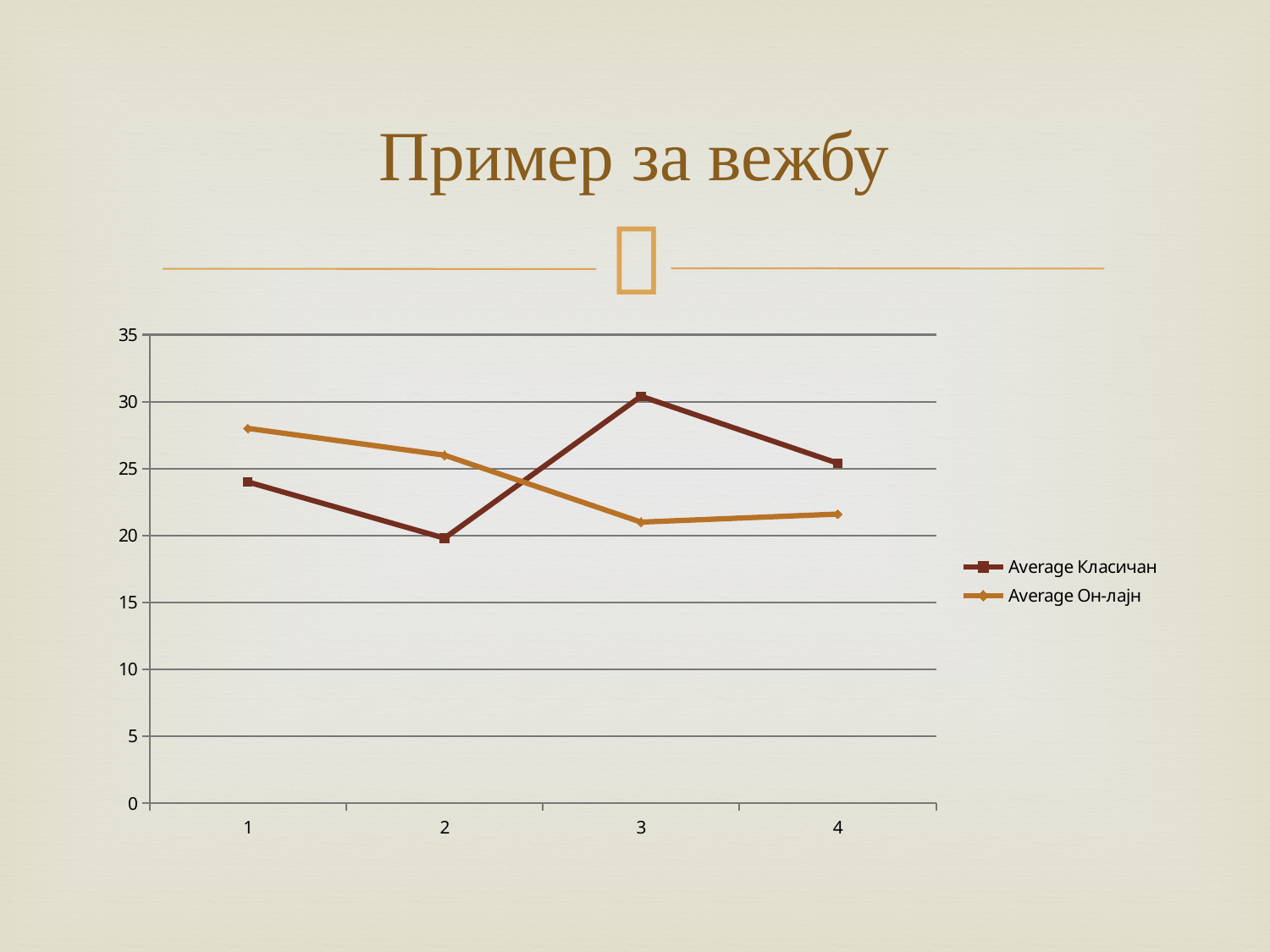
Which series is drawn in the darker brown line? Average Класичан At point 1, which series has the higher value, Average Класичан or Average Он-лајн? Average Он-лајн Does the Average Он-лајн series rise or fall from point 1 to point 3? fall What kind of chart is shown on the slide? line chart At which x-axis point does the Average Класичан series reach its lowest value? 2 Is the value of Average Класичан at point 2 greater or less than 25? less How many series does the legend list? 2 How many points are plotted along the x axis for each series? 4 At which x-axis point does the Average Он-лајн series reach its highest value? 1 At which x-axis point does the Average Класичан series reach its highest value? 3 Is the value of Average Класичан at point 3 greater or less than 25? greater Is the value of Average Он-лајн at point 3 greater or less than 25? less